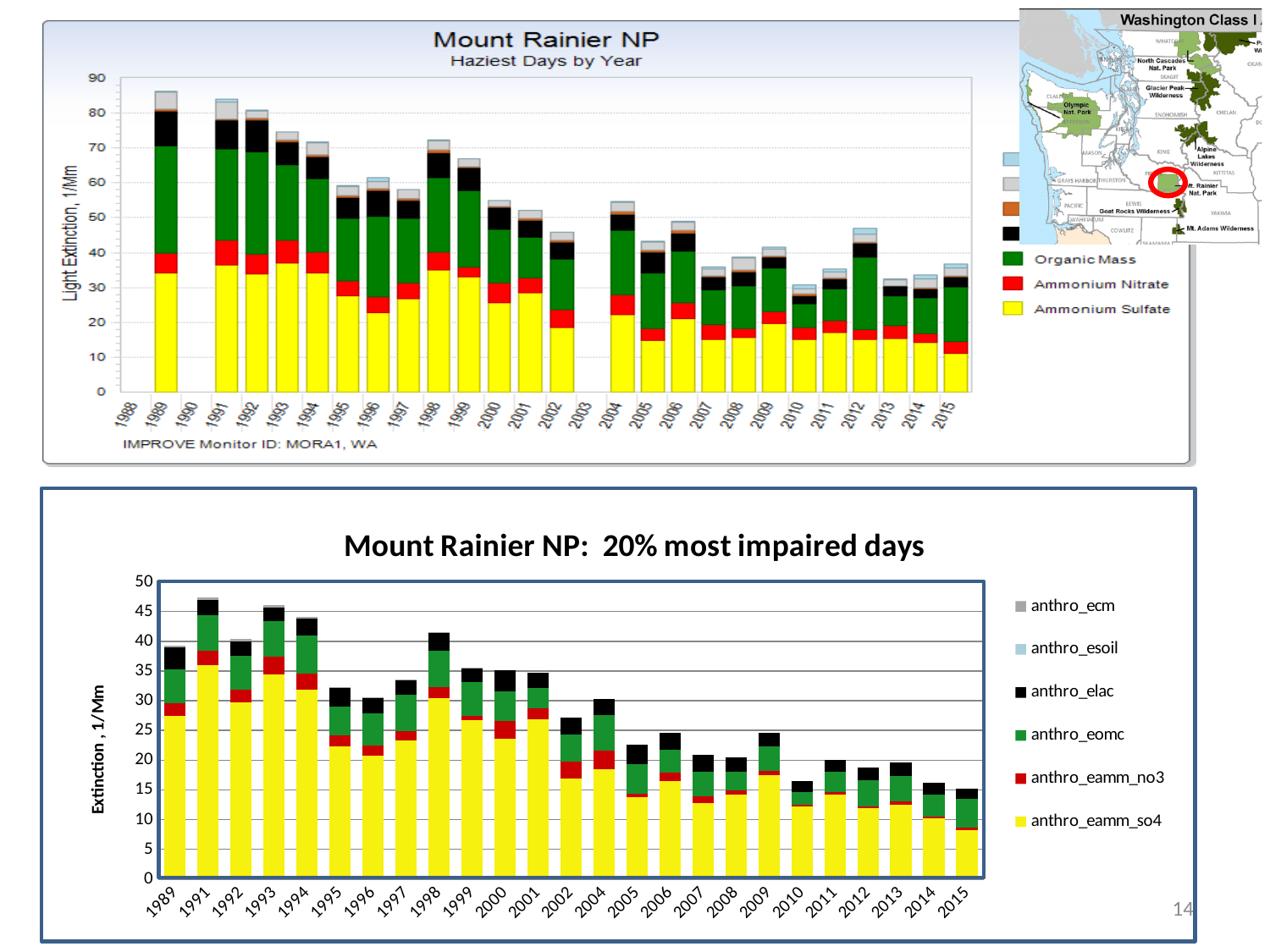
In the 'Mount Rainier NP: 20% most impaired days' chart, how many bars (years) are plotted? 25 What kind of chart is the 'Mount Rainier NP: 20% most impaired days' chart? Stacked bar chart In the 'Mount Rainier NP: 20% most impaired days' chart, how many series does the legend list? 6 In the 'Mount Rainier NP Haziest Days by Year' chart, is the total for 1989 greater or less than 80? greater In the 'Mount Rainier NP: 20% most impaired days' chart, do the bar totals generally rise or fall from 1989 to 2015? Fall In the 'Mount Rainier NP: 20% most impaired days' chart, which year has the tallest bar? 1991 In the 'Mount Rainier NP: 20% most impaired days' chart, which year has the shortest bar? 2015 In the 'Mount Rainier NP: 20% most impaired days' chart, which year has the larger total, 1998 or 1999? 1998 In the 'Mount Rainier NP Haziest Days by Year' chart, which year has the larger total, 1991 or 2012? 1991 What IMPROVE Monitor ID is shown below the 'Mount Rainier NP Haziest Days by Year' chart? MORA1, WA In the 'Mount Rainier NP: 20% most impaired days' chart, is the total for 1991 greater or less than 45? greater In the 'Mount Rainier NP: 20% most impaired days' chart, is the total for 2015 greater or less than 20? less